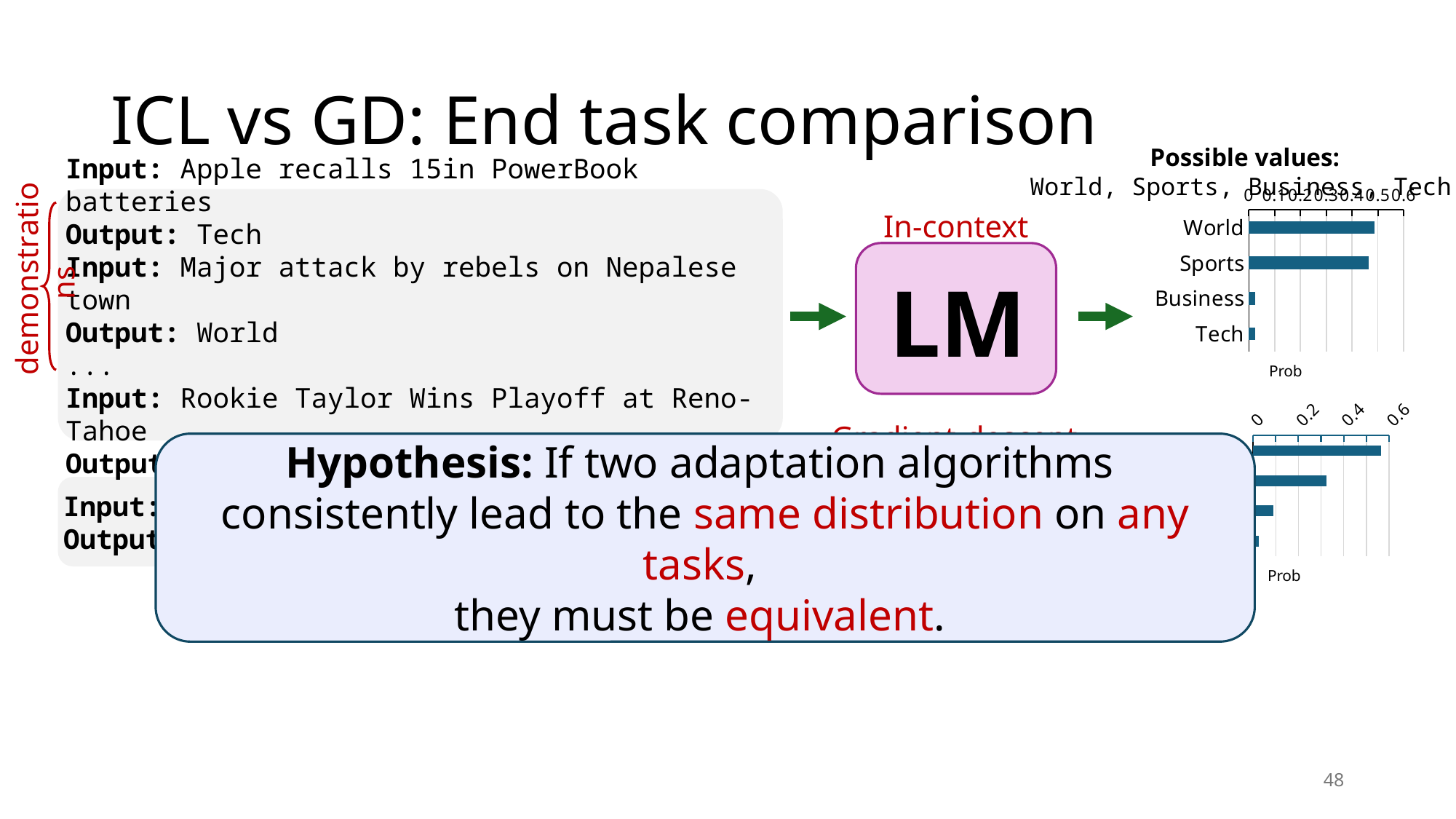
In the upper chart on the right, is the value for Tech greater or less than 0.1? less In the upper chart on the right, is the value for Sports greater or less than 0.3? greater What kind of chart is the upper chart on the right (labelled In-context)? bar chart In the upper chart on the right, which is larger, the value for Sports or the value for Tech? Sports In the lower chart on the right, how many bars are shown? 4 In the upper chart on the right, which is larger, the value for World or the value for Business? World What kind of chart is the lower chart on the right? bar chart What is the x-axis label of the upper chart on the right? Prob In the upper chart on the right, how many categories are shown? 4 In the lower chart on the right, is the longest bar greater or less than 0.4? greater